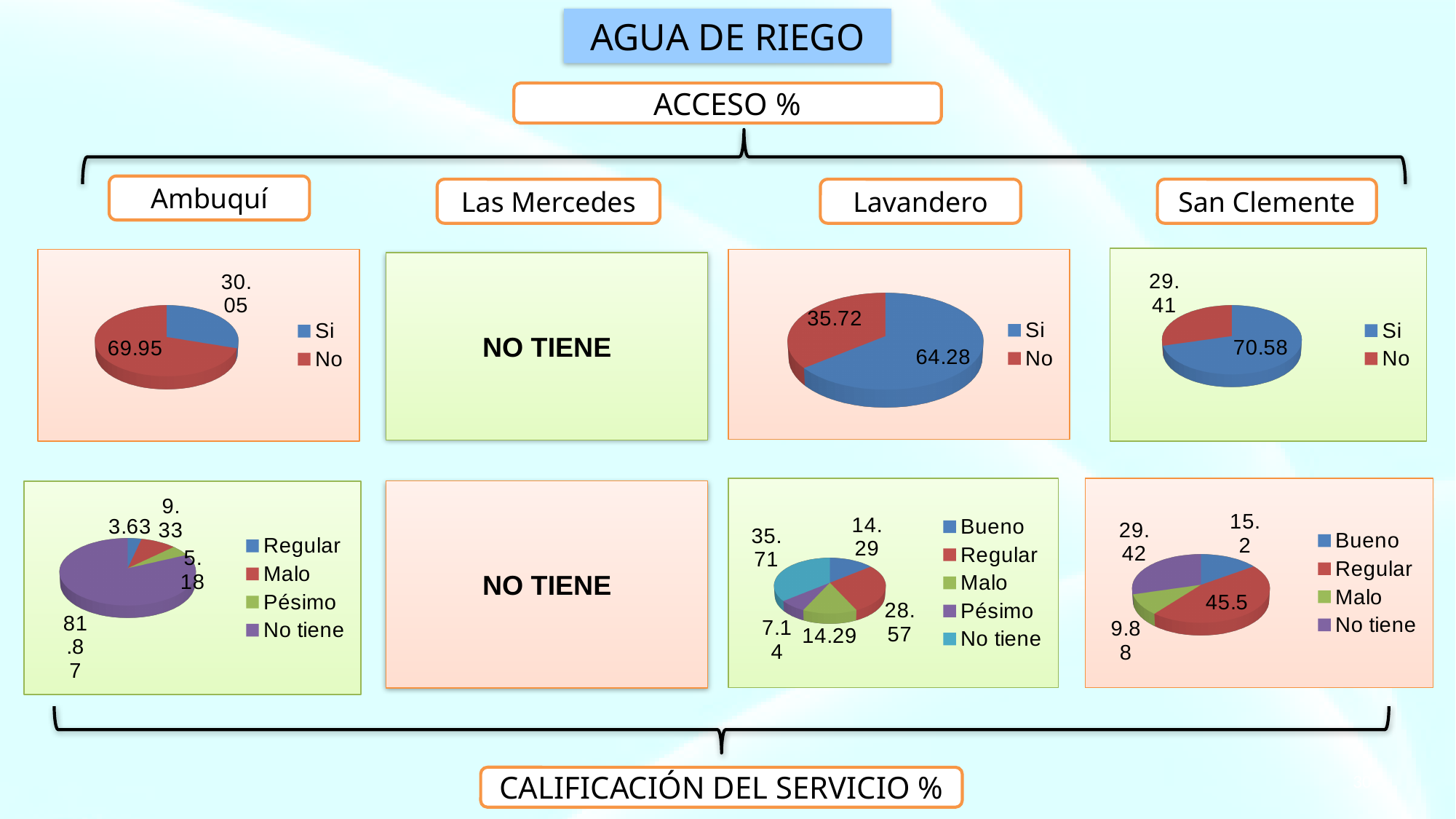
In the San Clemente service rating pie chart (bottom row), what is the value for "Regular"? 45.5 In the San Clemente access pie chart (top row), what is the value for "No"? 29.41 In the Ambuquí service rating pie chart (bottom row), what is the value for "Malo"? 9.33 In the Lavandero service rating pie chart (bottom row), which category has the smallest slice? Pésimo How many categories does the legend of the Lavandero service rating pie chart (bottom row) list? 5 In the Lavandero service rating pie chart (bottom row), what is the value for "Regular"? 28.57 In the San Clemente access pie chart (top row), what is the difference between the "Si" and "No" values? 41.17 What type of chart is used for the Lavandero access data (top row)? Pie chart In the Ambuquí access pie chart (top row), what is the value for "No"? 69.95 In the San Clemente service rating pie chart (bottom row), which is larger, "Bueno" or "No tiene"? No tiene In the Ambuquí service rating pie chart (bottom row), which category has the largest slice? No tiene In the Lavandero access pie chart (top row), what is the value for "Si"? 64.28